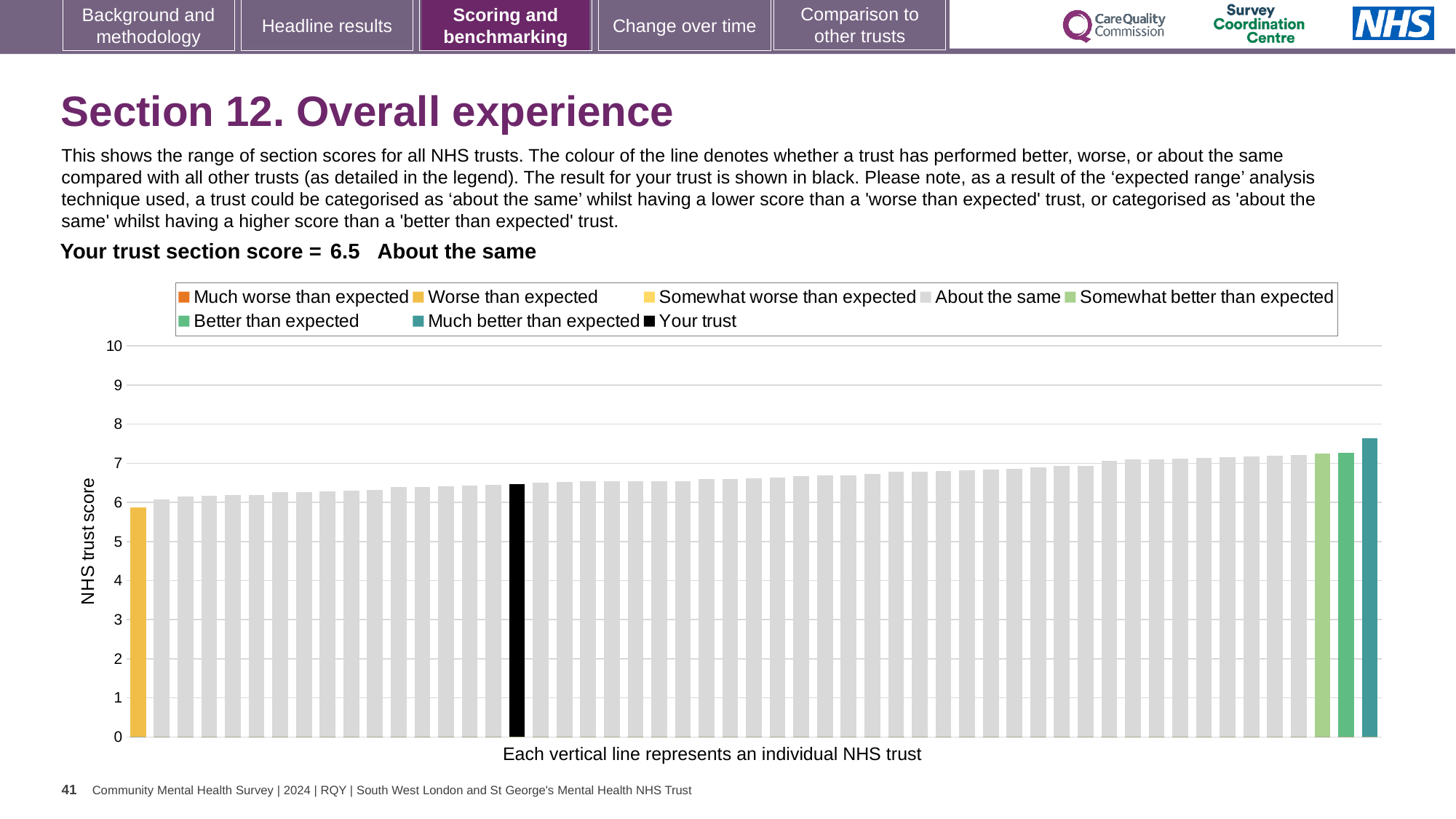
How many entries does the chart legend list? 8 What is the section score for your trust? 6.5 Which legend category does the shortest bar belong to? Worse than expected Is the value for your trust (the black bar) greater or less than 7? less What is the label on the vertical axis of the chart? NHS trust score Is the value for the tallest bar (the rightmost, 'Much better than expected' bar) greater or less than 7? greater Is the value for the shortest bar (the leftmost, 'Worse than expected' bar) greater or less than 5? greater How many bars are coloured as 'Much better than expected'? 1 Which is taller: the black 'Your trust' bar or the rightmost teal bar? the rightmost teal bar What kind of chart is shown on the slide? bar chart Do the bar values rise or fall from left to right along the x axis? rise Which legend category does the tallest bar belong to? Much better than expected